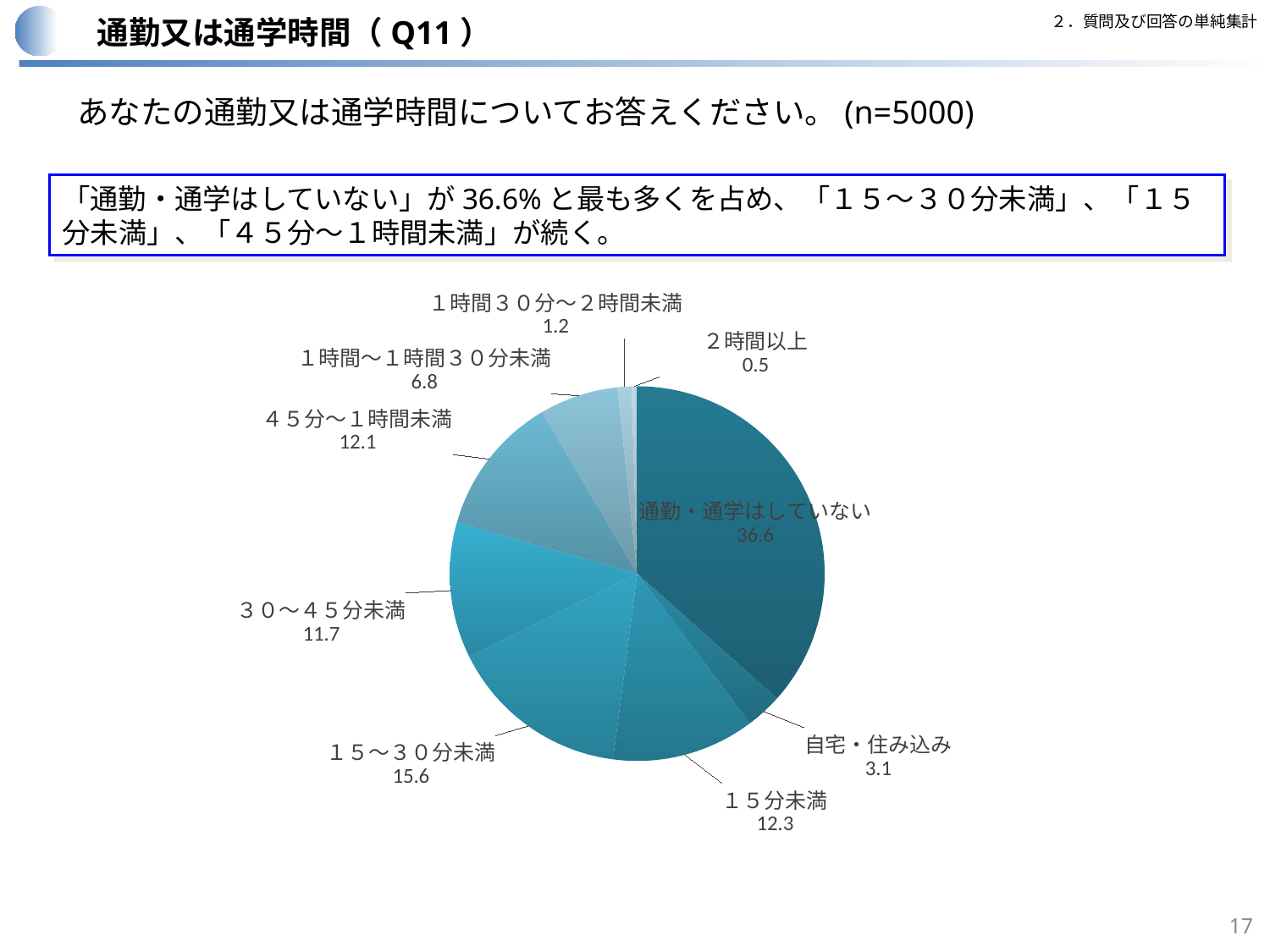
What is the value shown for １５～３０分未満? 15.6 What is the value shown for ２時間以上? 0.5 How many categories are shown in the pie chart? 9 Which category has the smallest slice of the pie? ２時間以上 What is the difference between the values for １５～３０分未満 and １５分未満? 3.3 What is the value shown for 通勤・通学はしていない in the pie chart? 36.6 Which is larger, the value for ３０～４５分未満 or the value for １時間～１時間３０分未満? ３０～４５分未満 What is the value shown for 自宅・住み込み? 3.1 What is the sample size (n) stated for this question on the slide? 5000 What kind of chart is shown on the slide? Pie chart Which category has the largest slice of the pie? 通勤・通学はしていない What is the difference between the values for 通勤・通学はしていない and １５～３０分未満? 21.0